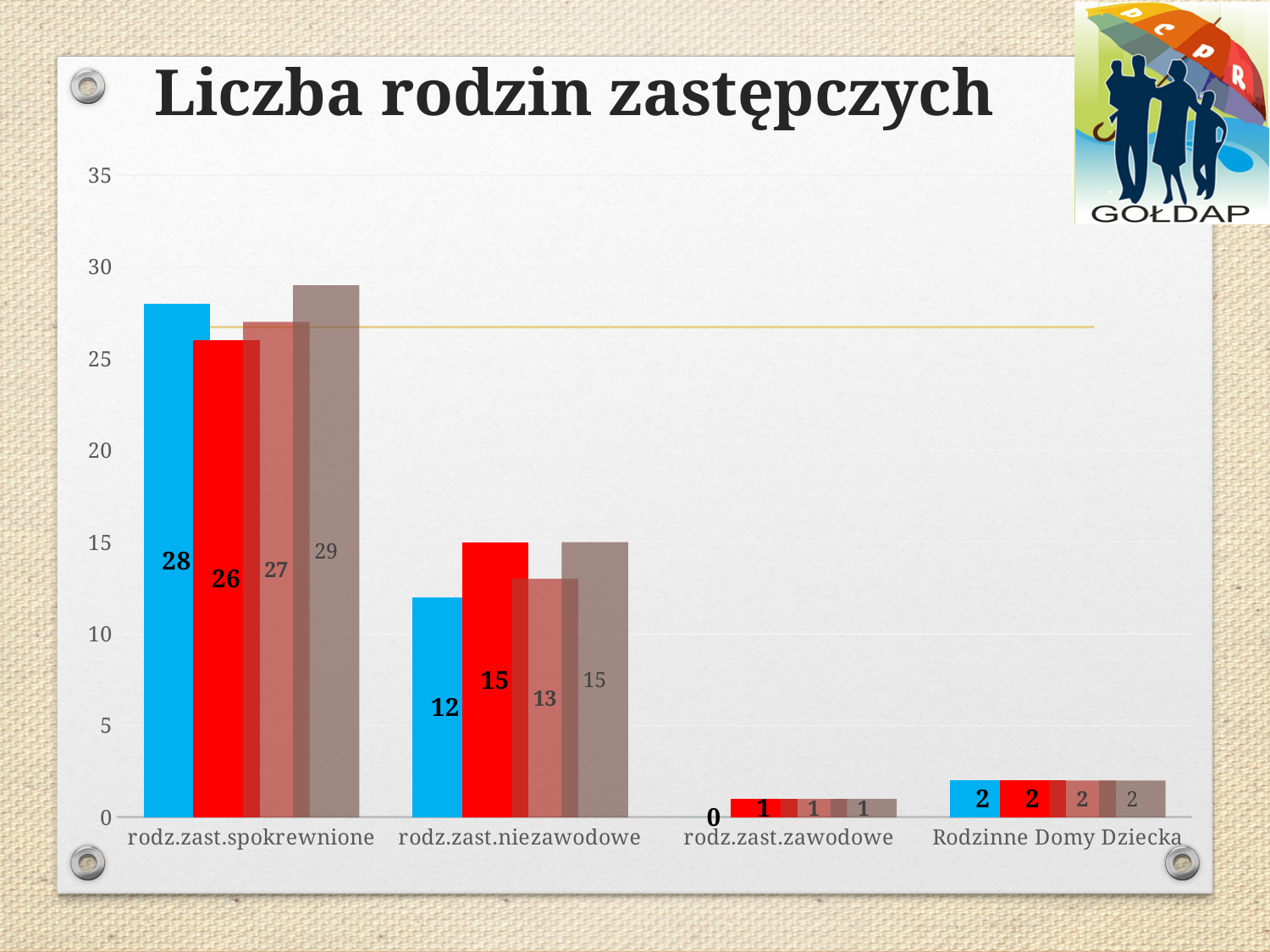
Which category has the lowest values overall? rodz.zast.zawodowe What is the value of the blue bar for rodz.zast.spokrewnione? 28 What is the title of the chart? Liczba rodzin zastępczych How many categories are shown on the x axis? 4 What is the value of the dark brown bar for rodz.zast.spokrewnione? 29 Which category has the highest values overall? rodz.zast.spokrewnione Which is larger for rodz.zast.niezawodowe: the blue bar or the red bar? the red bar What is the value of the blue bar for rodz.zast.zawodowe? 0 What is the difference between the dark brown bar and the red bar for rodz.zast.spokrewnione? 3 What is the value of the red bar for rodz.zast.niezawodowe? 15 How many bars are plotted for each category? 4 What kind of chart is shown on the slide? bar chart